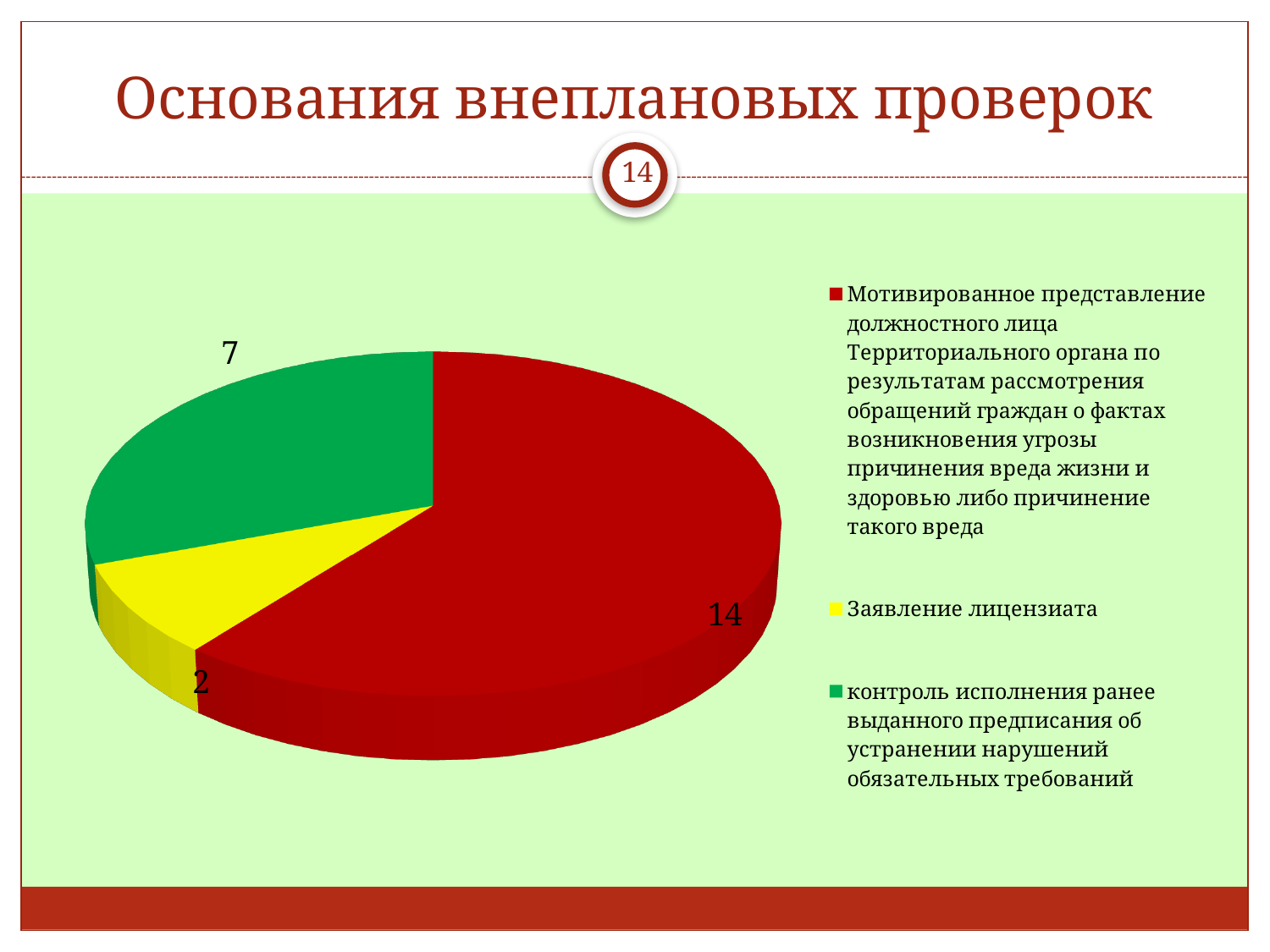
Which is larger: the slice for "Заявление лицензиата" or the slice for "контроль исполнения ранее выданного предписания"? контроль исполнения ранее выданного предписания Which category has the largest slice? Мотивированное представление должностного лица Территориального органа по результатам рассмотрения обращений граждан What is the value for "контроль исполнения ранее выданного предписания об устранении нарушений обязательных требований"? 7 What colour is the slice for "Заявление лицензиата"? Yellow Which category has the smallest slice? Заявление лицензиата What is the value for "Мотивированное представление должностного лица Территориального органа..."? 14 What is the value for "Заявление лицензиата"? 2 What is the difference between the largest slice (14) and the slice for "контроль исполнения ранее выданного предписания" (7)? 7 How many slices does the pie chart have? 3 How many entries does the legend list? 3 What kind of chart is shown on the slide? Pie chart What is the total of all slices in the pie chart? 23